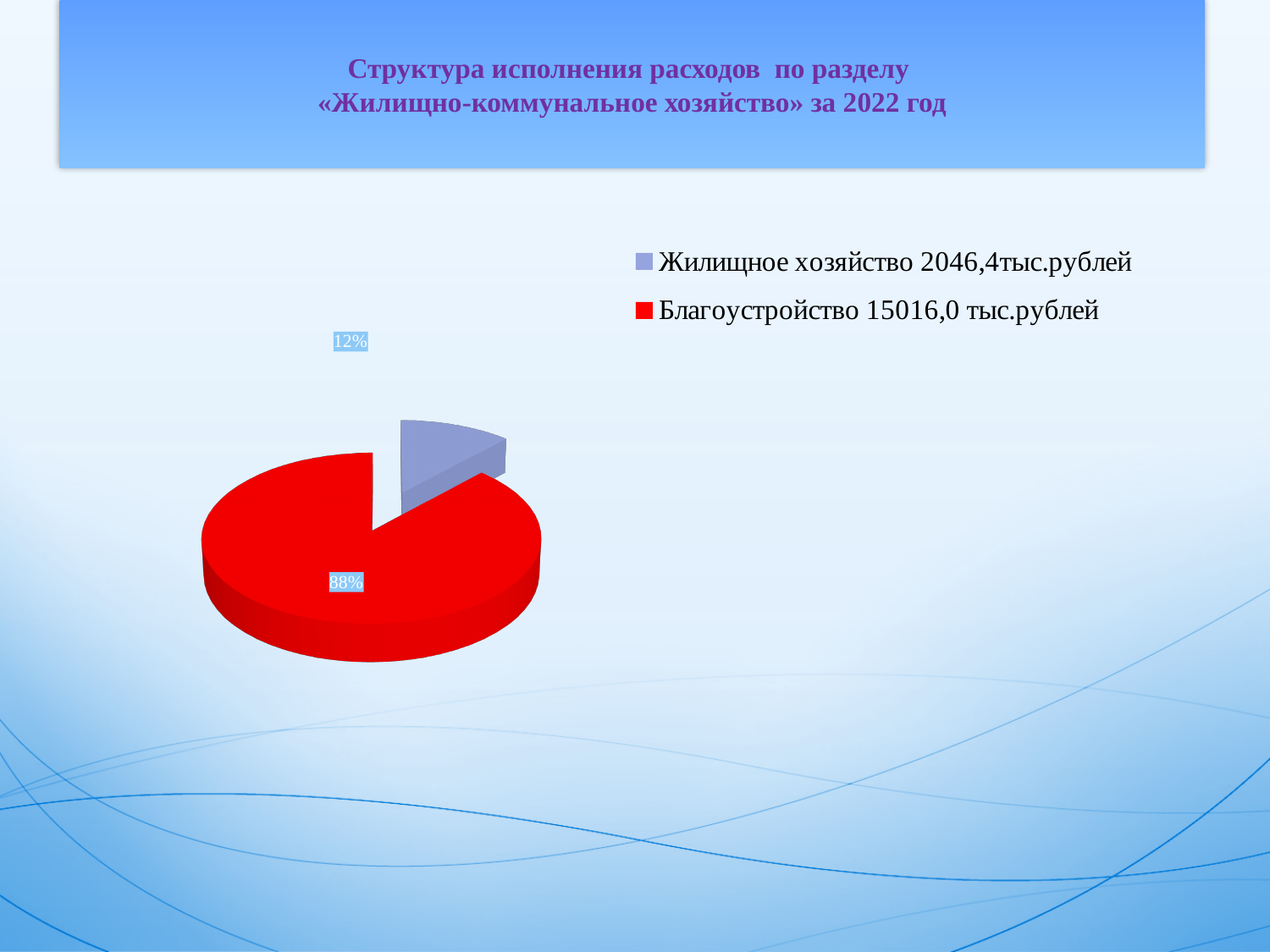
What is the difference in percentage points between the Благоустройство share and the Жилищное хозяйство share? 76 percentage points What kind of chart is shown on the slide? pie chart How many entries does the legend list? 2 Which category has the smallest share of the pie? Жилищное хозяйство How many slices does the pie chart have? 2 What amount in thousand rubles does the legend give for Жилищное хозяйство? 2046,4 тыс.рублей Which category has the largest share of the pie? Благоустройство What colour is the Благоустройство slice? red What amount in thousand rubles does the legend give for Благоустройство? 15016,0 тыс.рублей Which is larger: the share for Благоустройство or the share for Жилищное хозяйство? Благоустройство What share of the pie does Благоустройство take? 88% What share of the pie does Жилищное хозяйство take? 12%